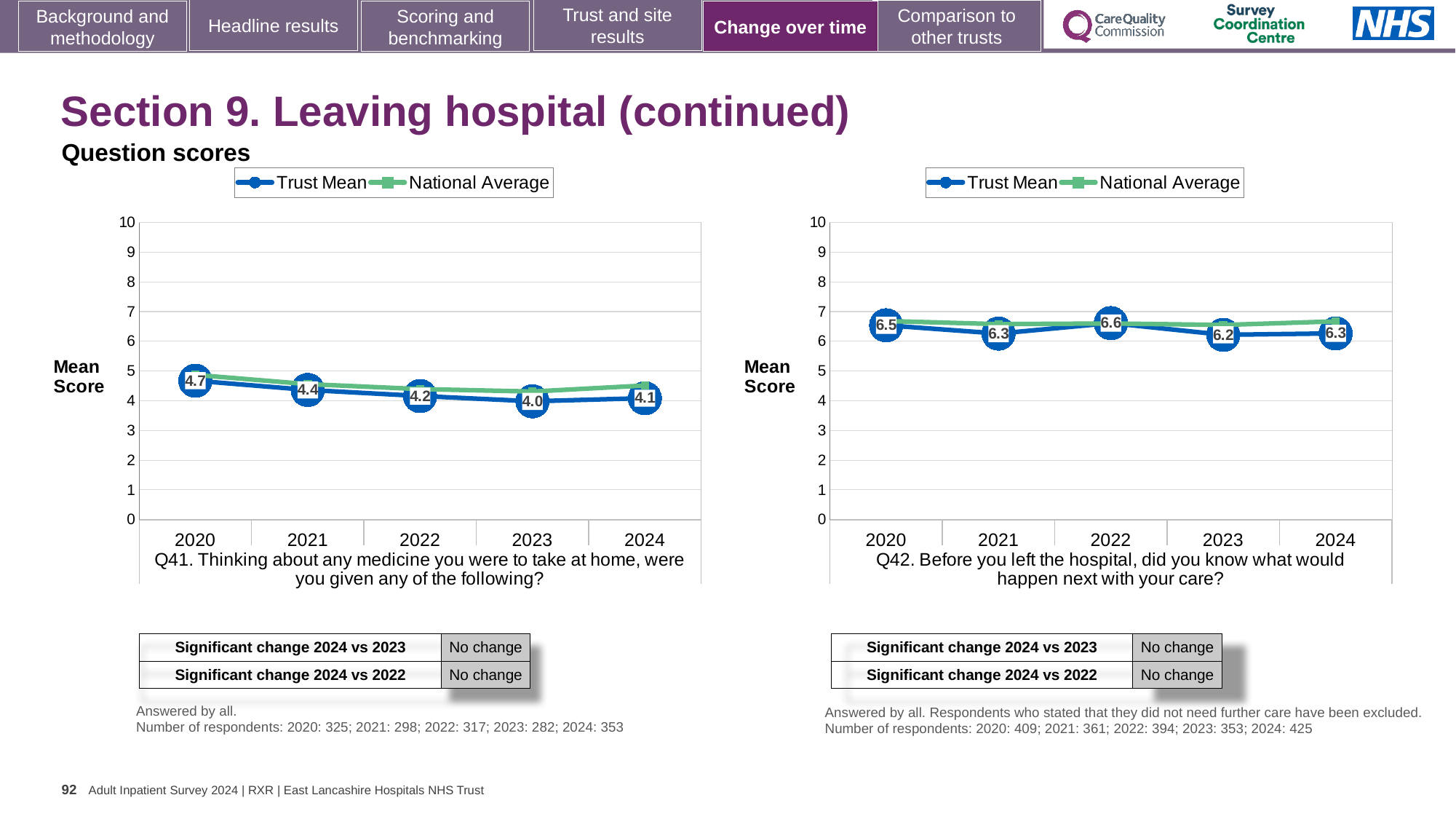
In the Q41 chart, what is the difference between the Trust Mean scores for 2020 and 2024? 0.6 In the Q42 chart, which year has the highest Trust Mean score? 2022 In the Q42 chart, what is the difference between the Trust Mean scores for 2022 and 2023? 0.4 What type of chart is the Q41 chart? line chart In the Q42 chart, what is the Trust Mean score for 2022? 6.6 How many series does the legend of the Q41 chart list? 2 In the Q41 chart, which year has the lowest Trust Mean score? 2023 How many years are plotted on the x axis of the Q42 chart? 5 In the Q41 chart, what is the Trust Mean score for 2020? 4.7 In the Q42 chart, is the Trust Mean score for 2021 or 2023 larger? 2021 In the Q41 chart, does the Trust Mean rise or fall from 2020 to 2023? fall In the Q41 chart, what is the Trust Mean score for 2023? 4.0